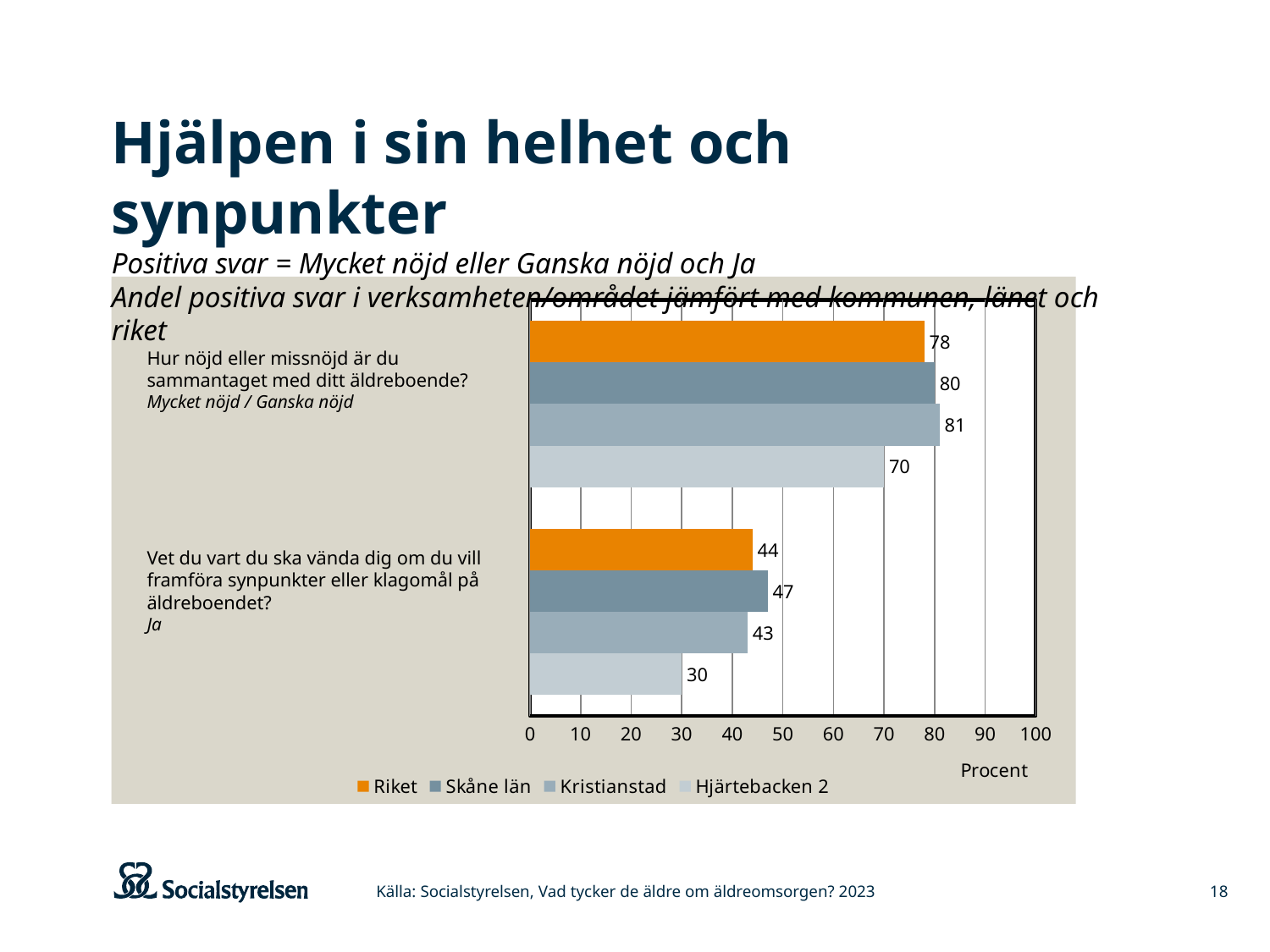
What is the value for Skåne län on the question "Vet du vart du ska vända dig om du vill framföra synpunkter eller klagomål på äldreboendet?"? 47 What is the label on the horizontal axis of the chart? Procent How many series does the legend list? 4 Is the value for Hjärtebacken 2 on the question "Hur nöjd eller missnöjd är du sammantaget med ditt äldreboende?" greater or less than 60? greater What kind of chart is shown on the slide? Bar chart What is the value for Hjärtebacken 2 on the question "Vet du vart du ska vända dig om du vill framföra synpunkter eller klagomål på äldreboendet?"? 30 What is the difference between the Kristianstad and Hjärtebacken 2 values on the question "Hur nöjd eller missnöjd är du sammantaget med ditt äldreboende?"? 11 Which series has the highest value on the question "Vet du vart du ska vända dig om du vill framföra synpunkter eller klagomål på äldreboendet?"? Skåne län Which series has the lowest value on the question "Hur nöjd eller missnöjd är du sammantaget med ditt äldreboende?"? Hjärtebacken 2 What is the value for Riket on the question "Hur nöjd eller missnöjd är du sammantaget med ditt äldreboende?"? 78 What is the difference between the Riket and Hjärtebacken 2 values on the question "Vet du vart du ska vända dig om du vill framföra synpunkter eller klagomål på äldreboendet?"? 14 What is the value for Kristianstad on the question "Hur nöjd eller missnöjd är du sammantaget med ditt äldreboende?"? 81